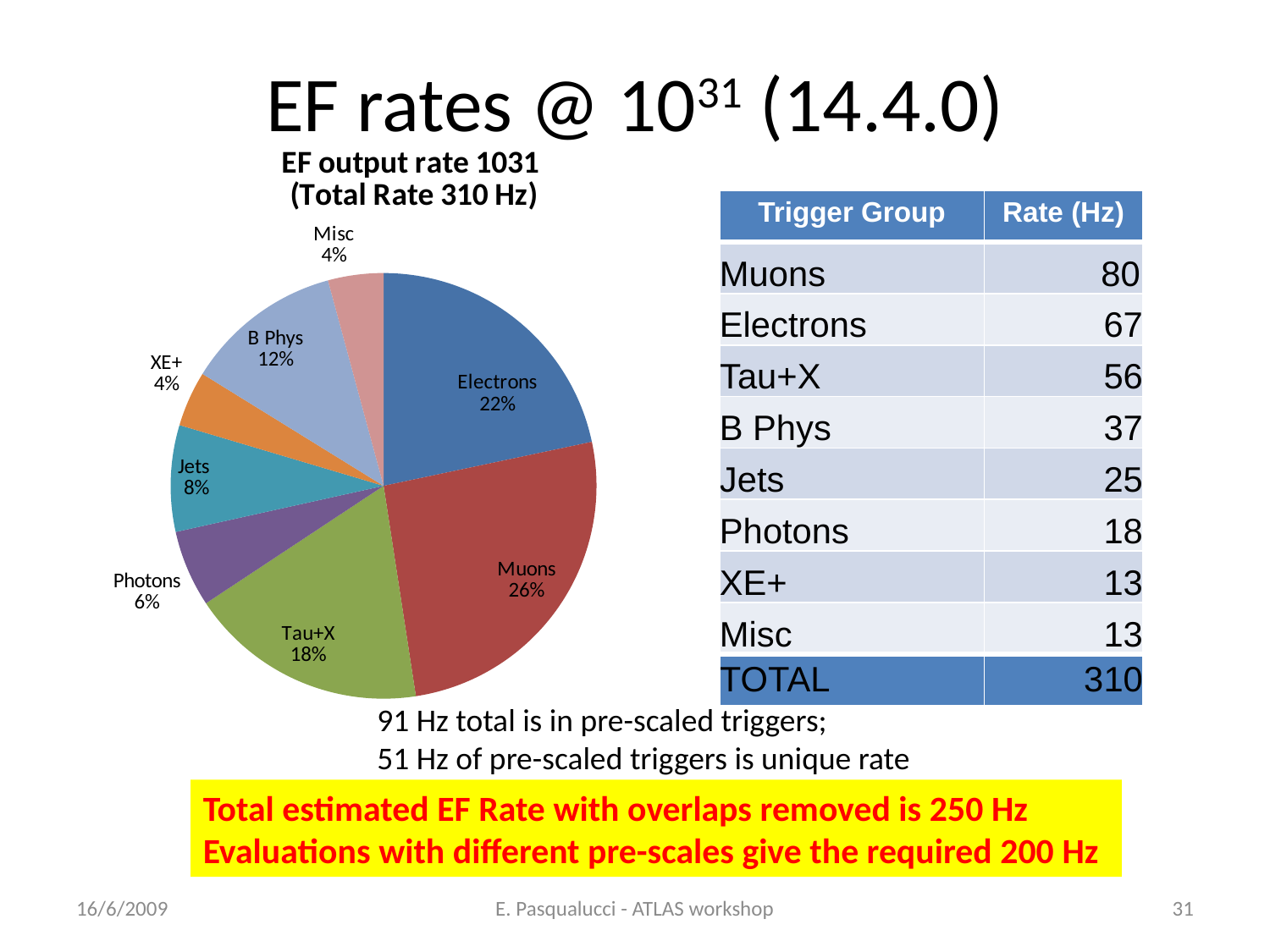
What percentage of the pie does the Electrons slice represent? 22% What is the title of the pie chart? EF output rate 1031 (Total Rate 310 Hz) What percentage of the pie does the Muons slice represent? 26% Which slice is larger, B Phys or Tau+X? Tau+X What percentage is shown for the B Phys slice? 12% Which slice of the pie chart is the largest? Muons Which slice is larger, Jets or Photons? Jets What is the difference in percentage points between the Muons slice and the Electrons slice? 4 What percentage is shown for the Tau+X slice? 18% How many slices does the pie chart have? 8 What type of chart is shown on the slide? pie chart What percentage is shown for the Misc slice? 4%